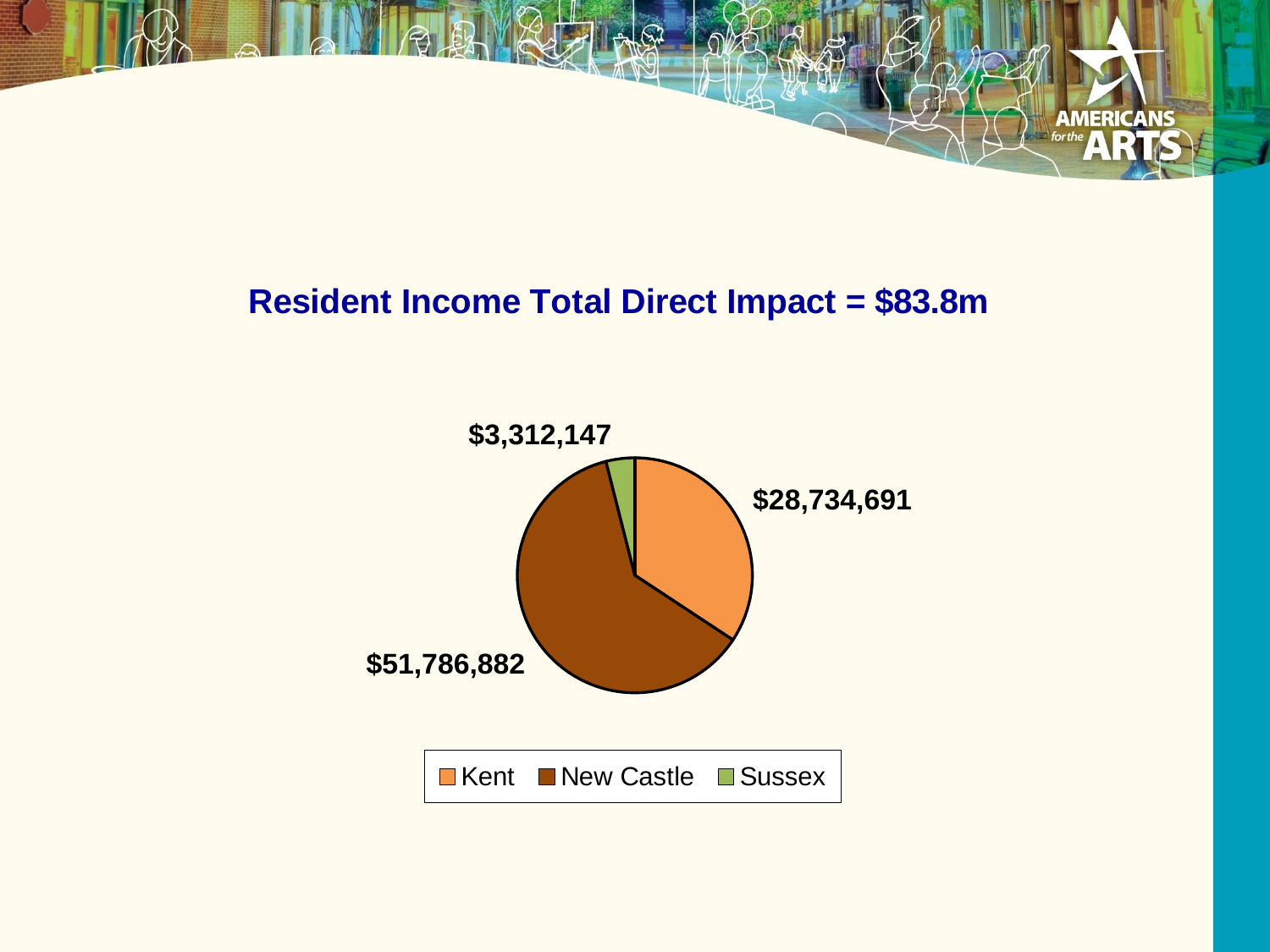
What is the value for Sussex in the pie chart? $3,312,147 Which county has the largest slice of the pie chart? New Castle Which is larger, the value for Kent or the value for Sussex? Kent How many entries does the legend list? 3 What is the title shown above the chart? Resident Income Total Direct Impact = $83.8m What is the difference between the Kent value and the Sussex value? $25,422,544 Which county has the smallest slice of the pie chart? Sussex What kind of chart is shown on the slide? Pie chart What is the value for New Castle in the pie chart? $51,786,882 What is the value for Kent in the pie chart? $28,734,691 How many slices does the pie chart have? 3 What is the difference between the New Castle value and the Kent value? $23,052,191